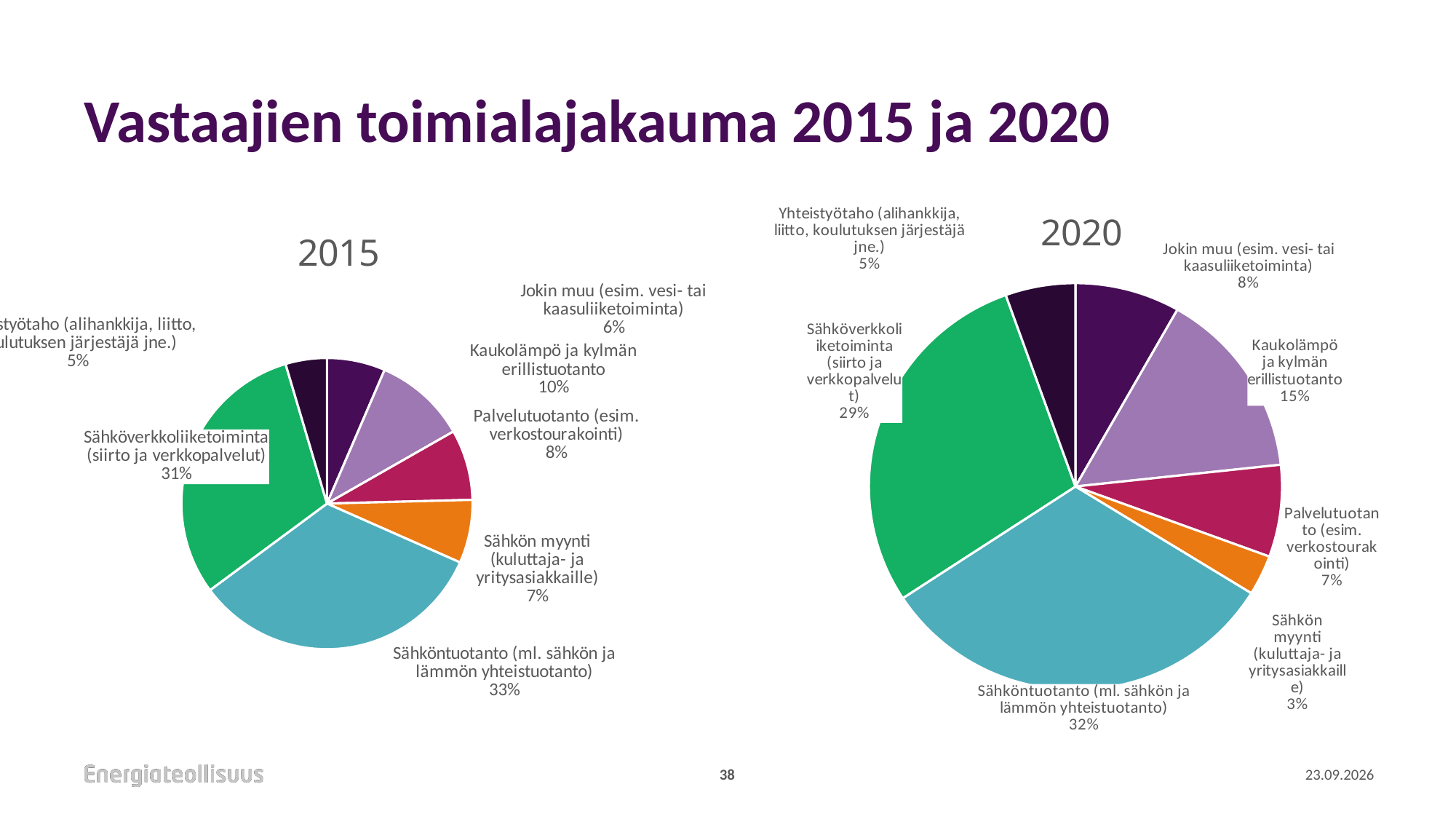
Comparing the two charts, is the share of Kaukolämpö ja kylmän erillistuotanto larger in 2015 or in 2020? 2020 In the 2020 pie chart, which category has the smallest share? Sähkön myynti (kuluttaja- ja yritysasiakkaille) In the 2015 pie chart, what share does Sähköntuotanto (ml. sähkön ja lämmön yhteistuotanto) have? 33% In the 2020 pie chart, what share does Kaukolämpö ja kylmän erillistuotanto have? 15% In the 2020 pie chart, which is larger: Jokin muu (esim. vesi- tai kaasuliiketoiminta) or Palvelutuotanto (esim. verkostourakointi)? Jokin muu (esim. vesi- tai kaasuliiketoiminta) What is the title of the slide? Vastaajien toimialajakauma 2015 ja 2020 In the 2020 pie chart, what share does Sähkön myynti (kuluttaja- ja yritysasiakkaille) have? 3% What type of chart is used for the 2015 data on the slide? Pie chart In the 2015 pie chart, which category has the largest share? Sähköntuotanto (ml. sähkön ja lämmön yhteistuotanto) In the 2015 pie chart, what share does Sähkön myynti (kuluttaja- ja yritysasiakkaille) have? 7% In the 2015 pie chart, what is the difference in percentage points between Sähköntuotanto (33%) and Sähköverkkoliiketoiminta (31%)? 2 percentage points How many slices does the 2020 pie chart have? 7